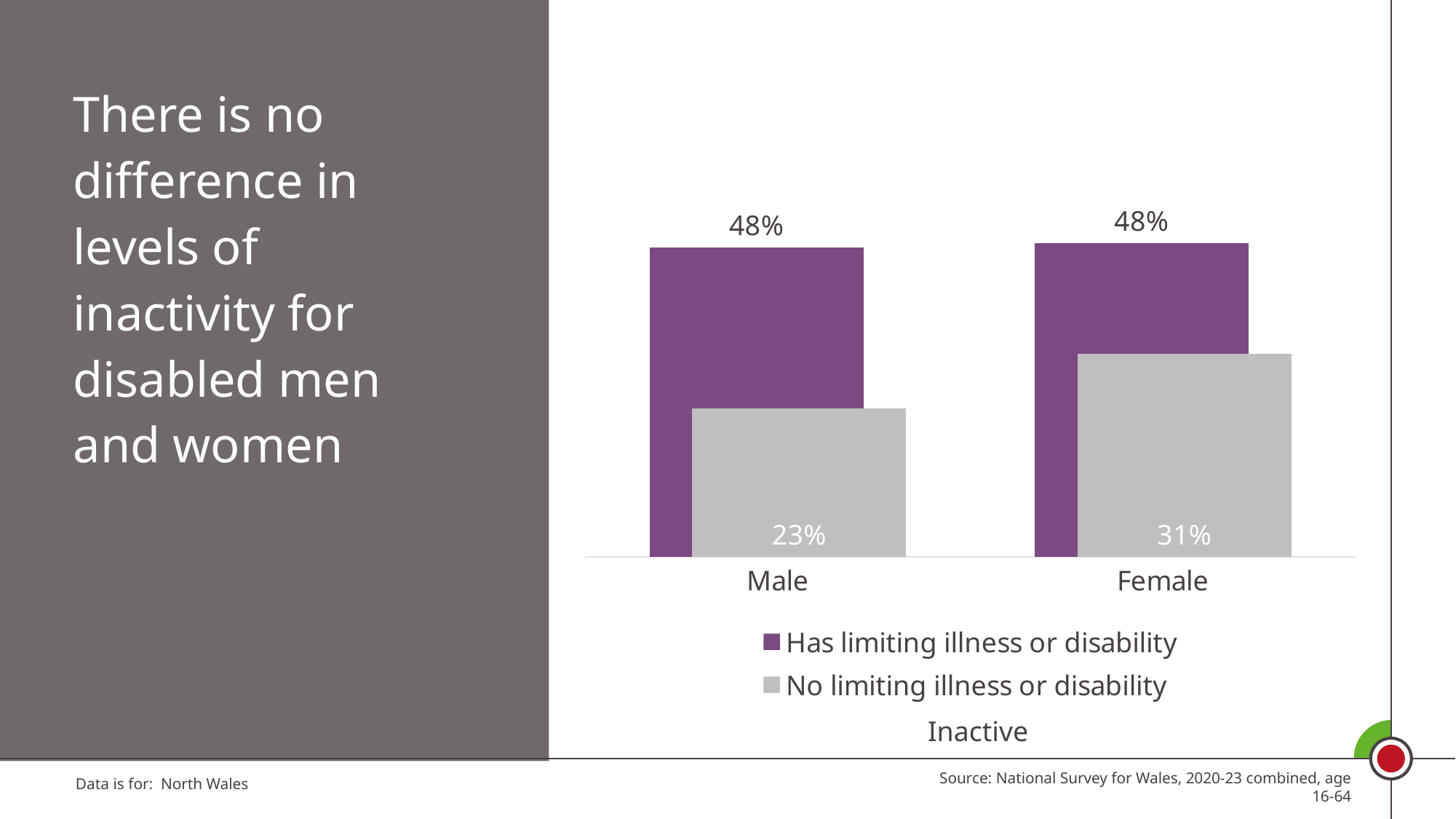
What is the value for Male in the 'No limiting illness or disability' series? 23% What is the difference between the 'No limiting illness or disability' values for Female and Male? 8% What is the difference between the 'Has limiting illness or disability' and 'No limiting illness or disability' values for Male? 25% What is the value for Male in the 'Has limiting illness or disability' series? 48% What is the value for Female in the 'No limiting illness or disability' series? 31% How many series does the legend list? 2 How many categories are shown on the x axis? 2 For Female, which is larger: 'Has limiting illness or disability' or 'No limiting illness or disability'? Has limiting illness or disability What is the title of the chart? Inactive What kind of chart is shown on the slide? Bar chart Which category has the lowest value in the 'No limiting illness or disability' series? Male What is the value for Female in the 'Has limiting illness or disability' series? 48%